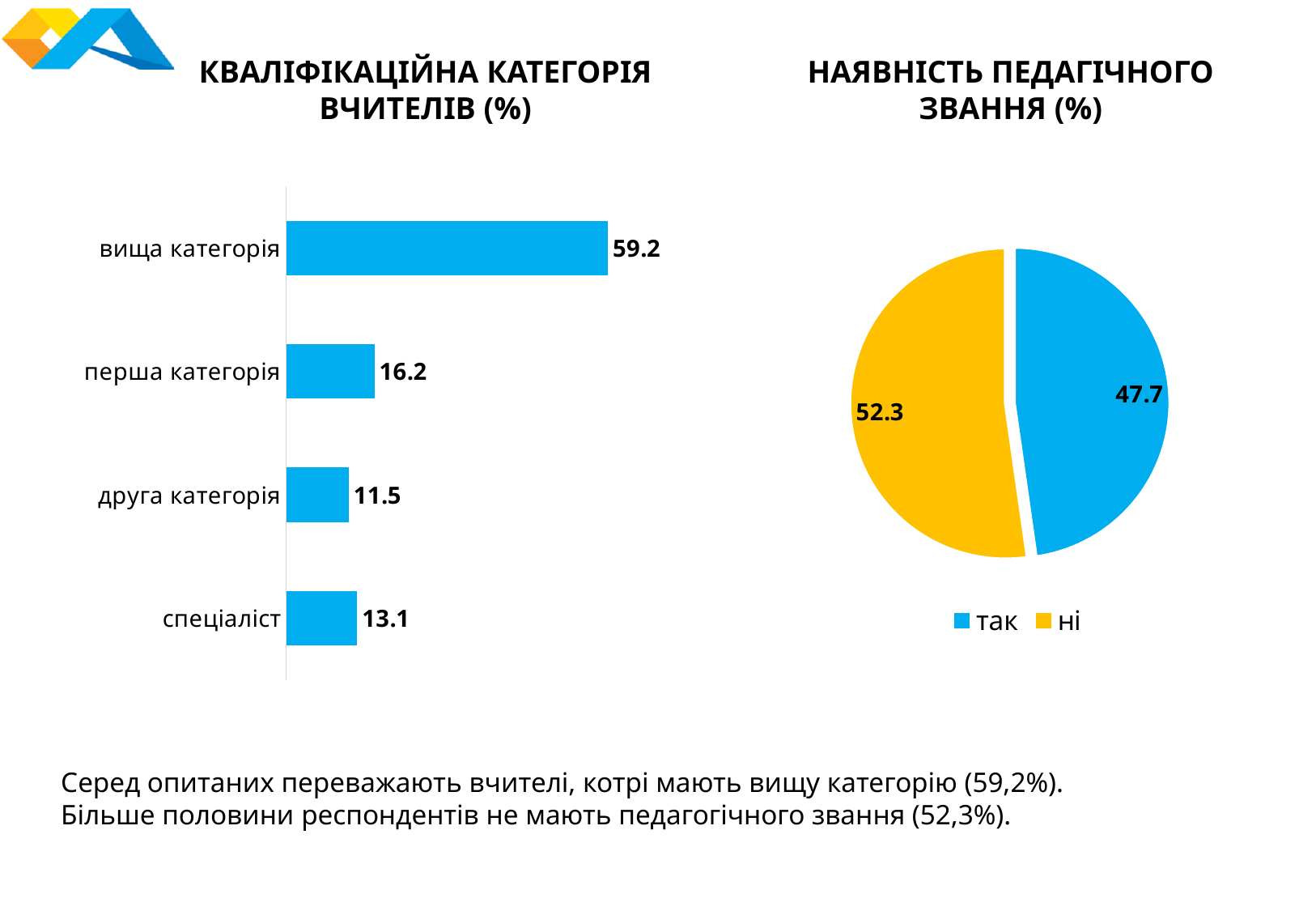
In the chart titled 'КВАЛІФІКАЦІЙНА КАТЕГОРІЯ ВЧИТЕЛІВ (%)', what is the value for 'вища категорія'? 59.2 In the chart titled 'КВАЛІФІКАЦІЙНА КАТЕГОРІЯ ВЧИТЕЛІВ (%)', which category has the highest value? вища категорія In the chart titled 'НАЯВНІСТЬ ПЕДАГІЧНОГО ЗВАННЯ (%)', what is the value for 'так'? 47.7 What kind of chart is the one titled 'КВАЛІФІКАЦІЙНА КАТЕГОРІЯ ВЧИТЕЛІВ (%)'? bar chart In the chart titled 'КВАЛІФІКАЦІЙНА КАТЕГОРІЯ ВЧИТЕЛІВ (%)', which is larger: 'спеціаліст' or 'друга категорія'? спеціаліст In the chart titled 'НАЯВНІСТЬ ПЕДАГІЧНОГО ЗВАННЯ (%)', what colour is the 'ні' slice? yellow In the chart titled 'КВАЛІФІКАЦІЙНА КАТЕГОРІЯ ВЧИТЕЛІВ (%)', what is the value for 'спеціаліст'? 13.1 In the chart titled 'КВАЛІФІКАЦІЙНА КАТЕГОРІЯ ВЧИТЕЛІВ (%)', what is the difference between 'вища категорія' and 'перша категорія'? 43 In the chart titled 'КВАЛІФІКАЦІЙНА КАТЕГОРІЯ ВЧИТЕЛІВ (%)', which category has the lowest value? друга категорія How many categories are shown in the chart titled 'КВАЛІФІКАЦІЙНА КАТЕГОРІЯ ВЧИТЕЛІВ (%)'? 4 What kind of chart is the one titled 'НАЯВНІСТЬ ПЕДАГІЧНОГО ЗВАННЯ (%)'? pie chart In the chart titled 'НАЯВНІСТЬ ПЕДАГІЧНОГО ЗВАННЯ (%)', which slice is larger: 'так' or 'ні'? ні